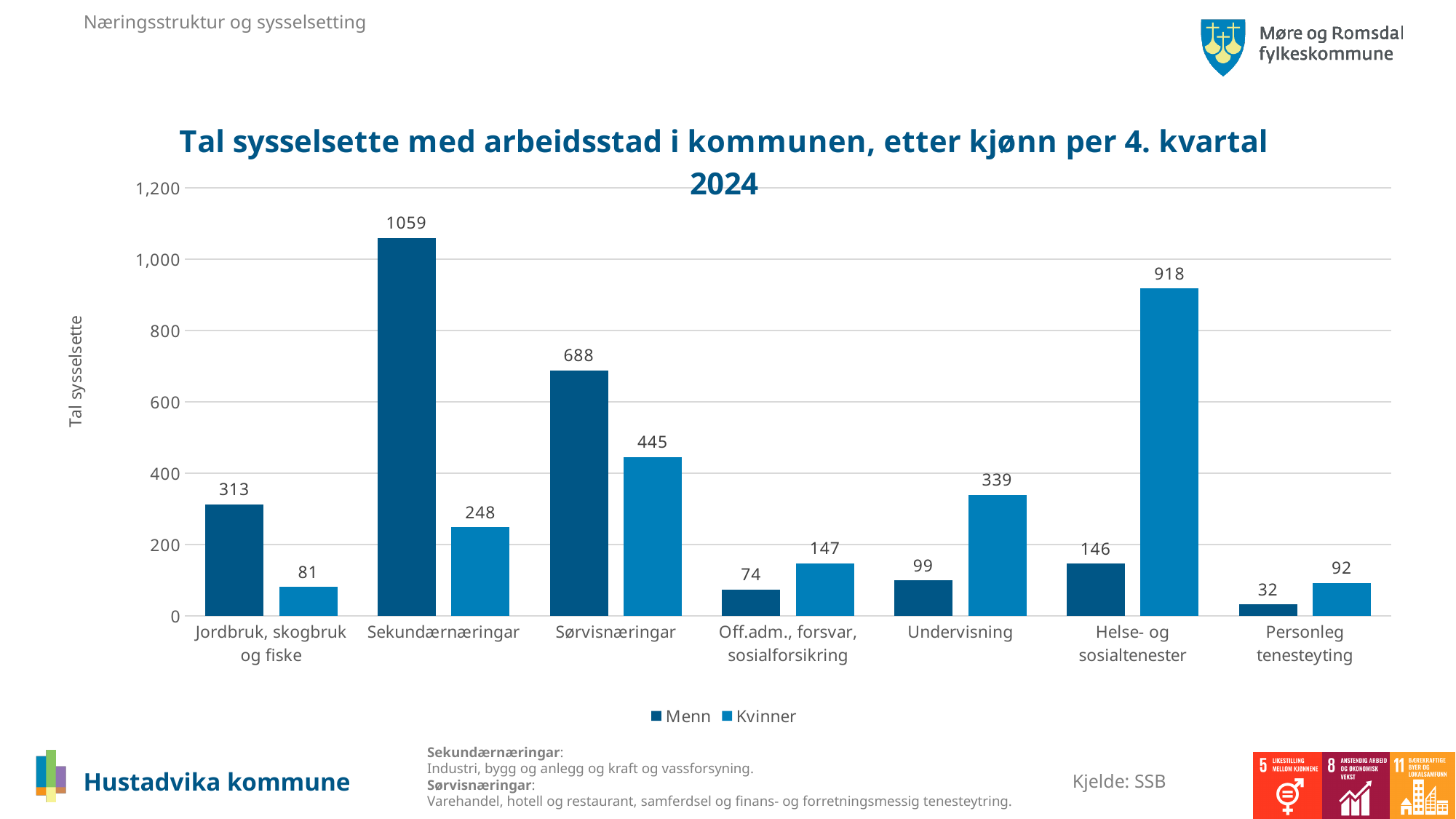
Is the value for Kvinner in Sekundærnæringar greater or less than 200? greater Which category has the highest value for Menn? Sekundærnæringar What kind of chart is shown? Bar chart Which is larger in Off.adm., forsvar, sosialforsikring: Menn or Kvinner? Kvinner How many categories are shown on the x axis? 7 What is the value for Menn in Sekundærnæringar? 1059 Which category has the lowest value for Kvinner? Jordbruk, skogbruk og fiske How many series does the legend list? 2 What is the difference between Menn and Kvinner in Sørvisnæringar? 243 What is the value for Kvinner in Helse- og sosialtenester? 918 What is the value for Kvinner in Undervisning? 339 What is the y-axis title of the chart? Tal sysselsette